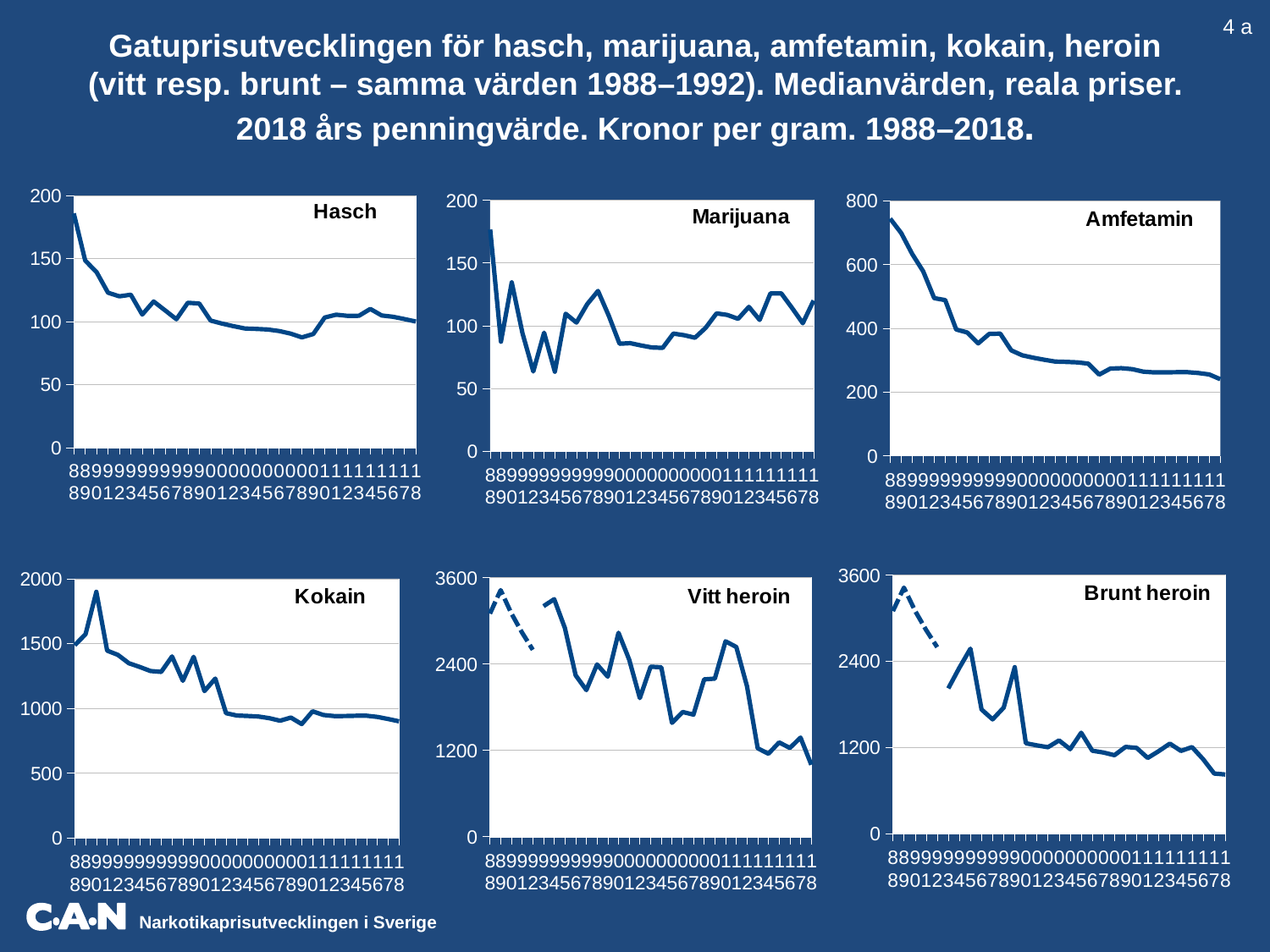
In the Brunt heroin chart, is the value for 2018 greater or less than 1200? less In the Amfetamin chart, is the value for 1988 greater or less than 600? greater In the Amfetamin chart, do the values generally rise or fall from 1988 to 2018? fall In the Marijuana chart, is the value for 1988 greater or less than 150? greater In the Kokain chart, do the values generally rise or fall from 1988 to 2018? fall What is the highest value shown on the y axis of the Vitt heroin chart? 3600 How many charts are shown on the slide? 6 What kind of chart is the Hasch chart? line chart What is the highest value shown on the y axis of the Amfetamin chart? 800